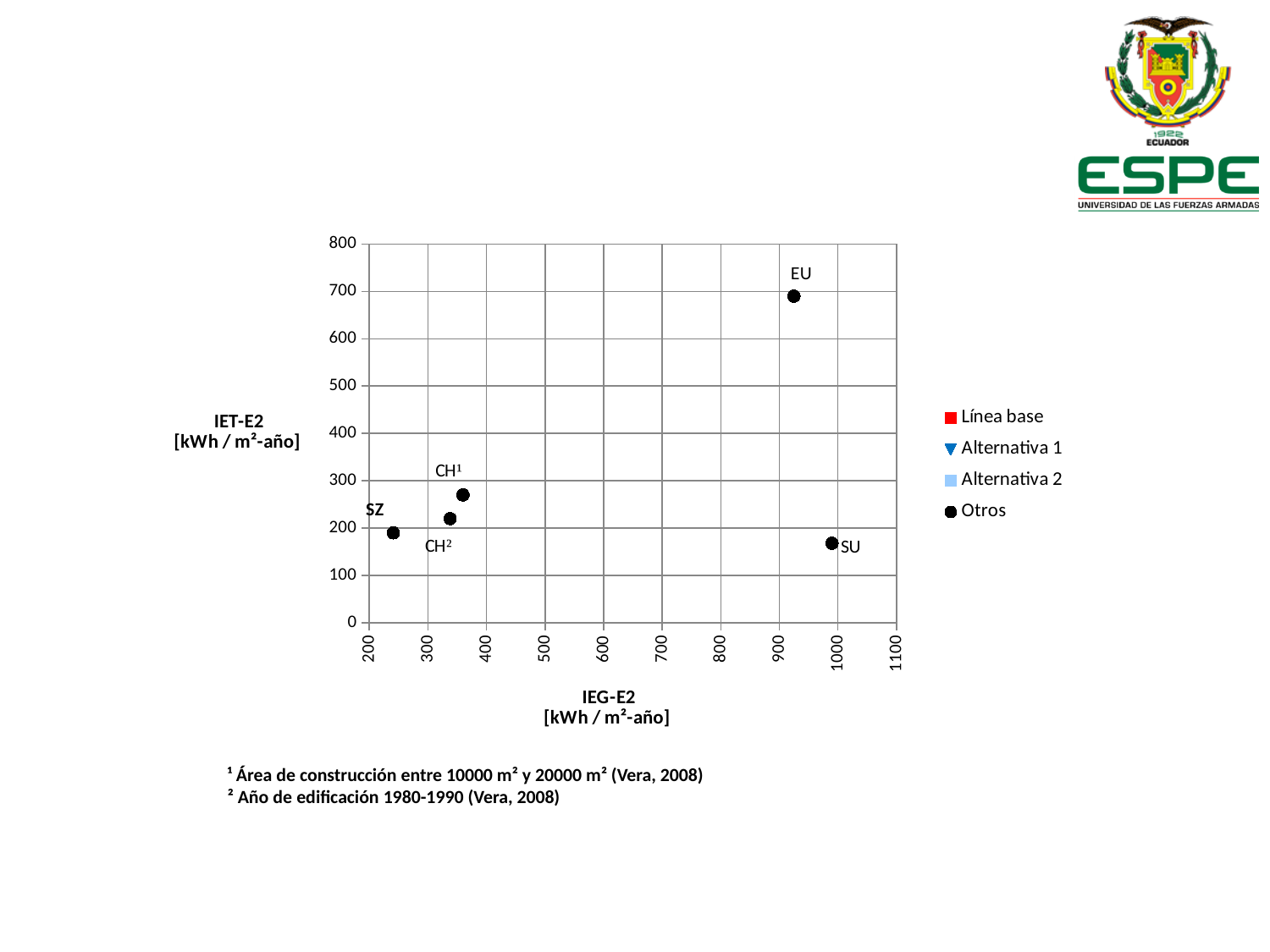
How many series does the legend list? 4 What is the title of the horizontal axis? IEG-E2 [kWh / m²-año] Is the IET-E2 value for EU greater or less than 600? greater Which labelled point has the lowest IET-E2 value? SU Which labelled point has the highest IET-E2 value? EU Which has the larger IET-E2 value, CH¹ or CH²? CH¹ Is the IEG-E2 value for SU greater or less than 900? greater Which has the larger IET-E2 value, EU or SU? EU How many data points are plotted on the chart? 5 What kind of chart is shown on the slide? scatter chart Is the IET-E2 value for CH¹ greater or less than 300? less